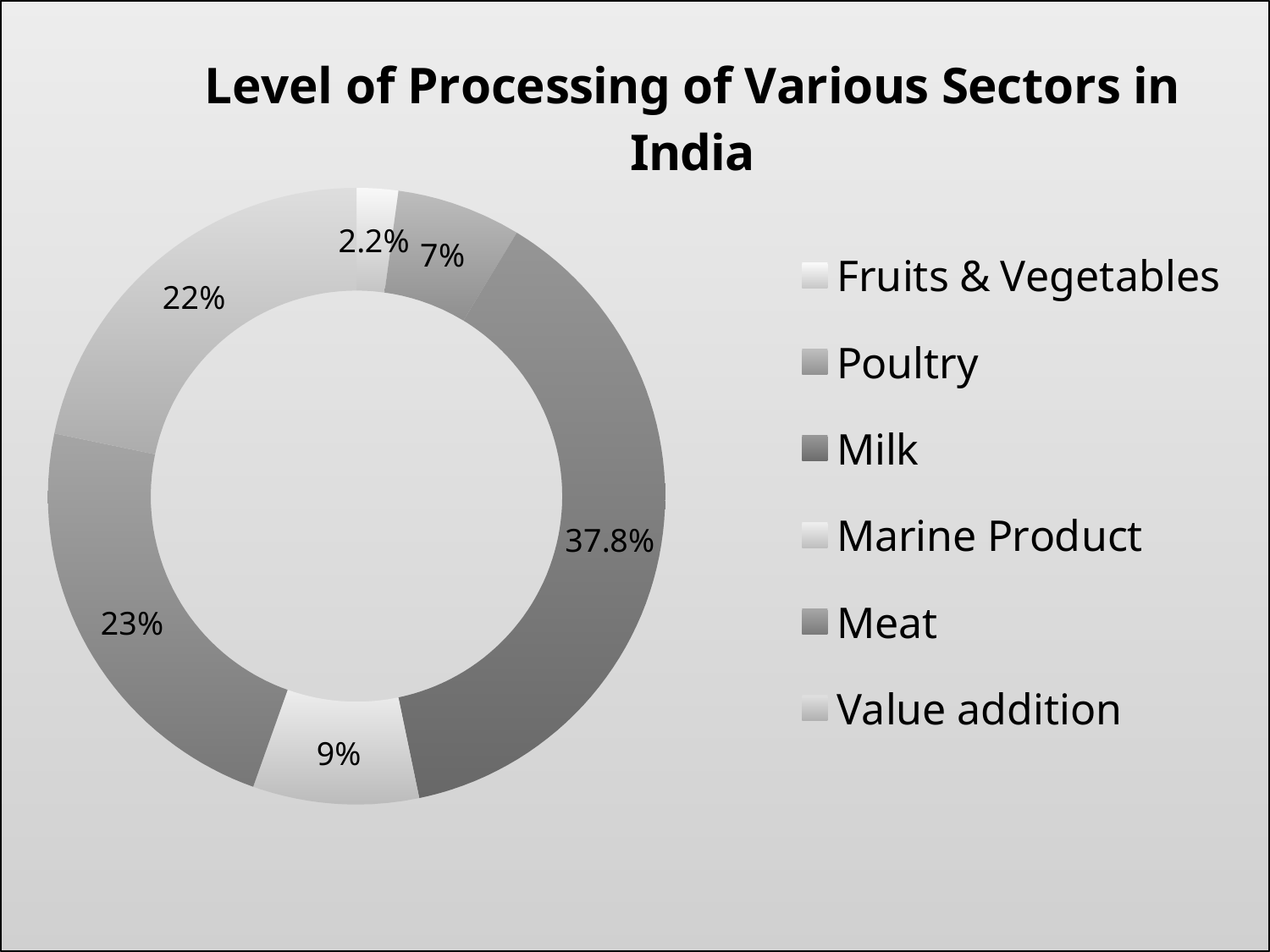
What is the value for Marine Product? 9% What is the title of the chart? Level of Processing of Various Sectors in India Which sector has the largest share? Milk What is the difference between the values for Milk and Poultry? 30.8% What is the value for Milk? 37.8% What kind of chart is shown on the slide? Doughnut chart Which is larger, the value for Meat or the value for Marine Product? Meat What is the value for Poultry? 7% What is the value for Fruits & Vegetables? 2.2% Which sector has the smallest share? Fruits & Vegetables What is the difference between the values for Meat and Value addition? 1% How many sectors does the legend list? 6